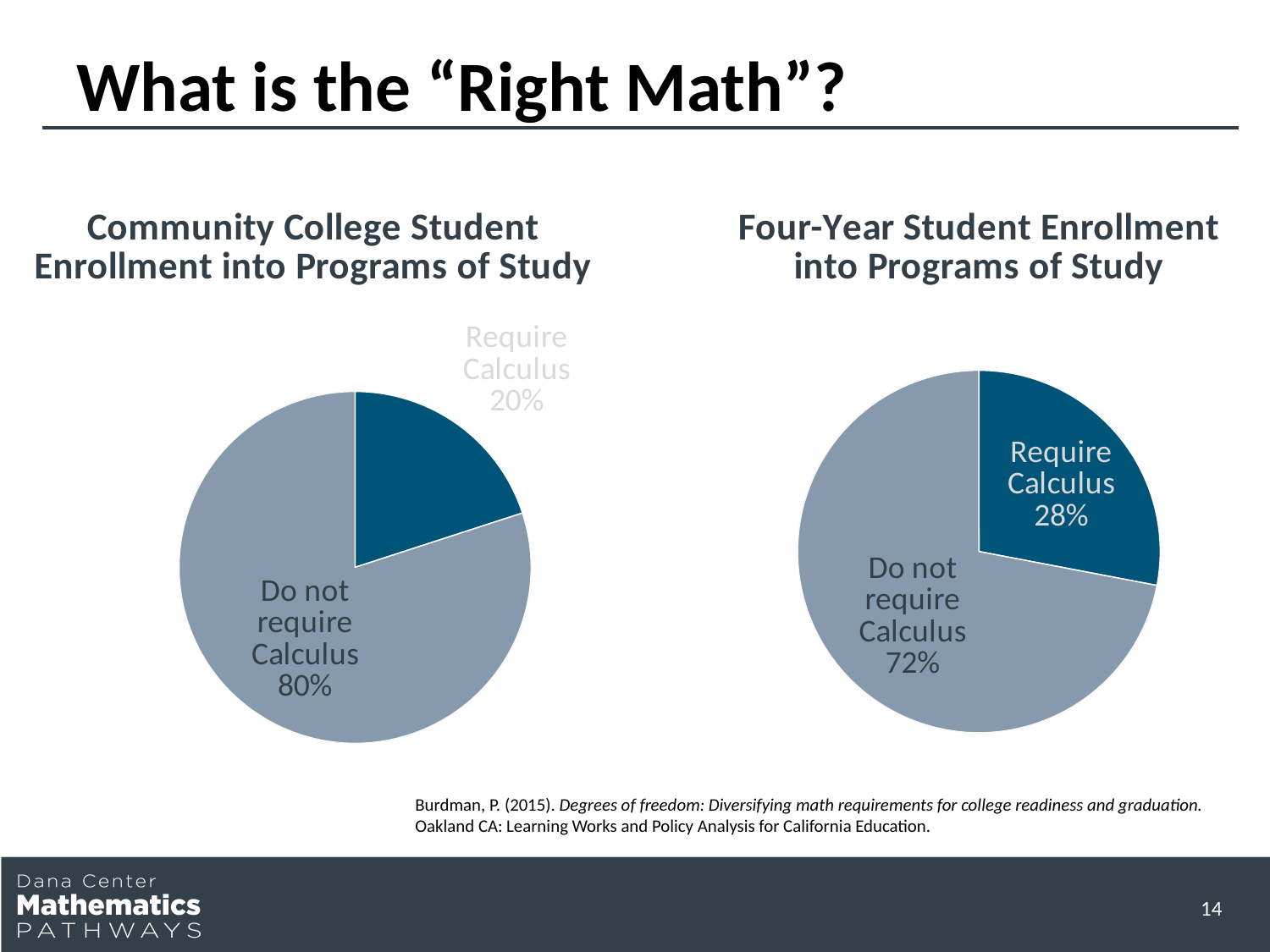
How many slices does the Four-Year Student Enrollment into Programs of Study pie chart have? 2 What kind of chart is the Community College Student Enrollment into Programs of Study chart? Pie chart In the Community College Student Enrollment into Programs of Study chart, what is the difference between the Do not require Calculus share and the Require Calculus share? 60 percentage points What is the title of the pie chart on the right side of the slide? Four-Year Student Enrollment into Programs of Study In the Four-Year Student Enrollment into Programs of Study chart, what share of programs do not require Calculus? 72% In the Community College Student Enrollment into Programs of Study chart, which slice is the largest? Do not require Calculus In the Community College Student Enrollment into Programs of Study chart, what share of programs do not require Calculus? 80% Which chart shows a larger share of programs that require Calculus, the Community College chart or the Four-Year chart? Four-Year Student Enrollment into Programs of Study In the Community College Student Enrollment into Programs of Study chart, what share of programs require Calculus? 20% What is the difference between the Require Calculus share in the Four-Year chart and the Require Calculus share in the Community College chart? 8 percentage points In the Four-Year Student Enrollment into Programs of Study chart, which slice is the smallest? Require Calculus